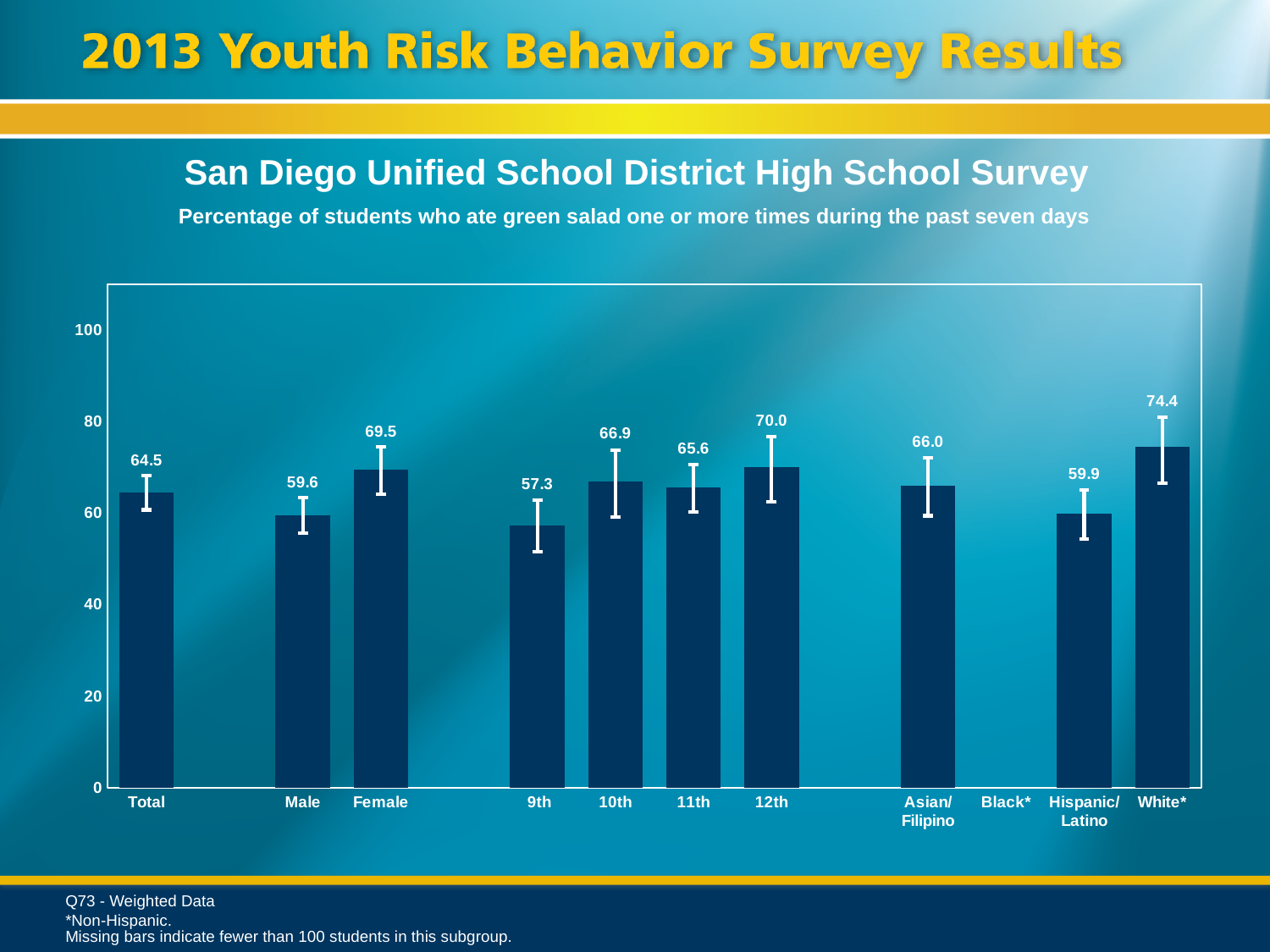
What kind of chart is shown? Bar chart Which is larger, the value for 10th grade or the value for 11th grade? 10th What is the difference between the Female and Male values? 9.9 What is the value for 12th grade? 70.0 What is the value for Female? 69.5 Which category has no bar shown on the chart? Black* What is the value for Total? 64.5 How many bars are plotted on the chart? 10 What is the difference between the 12th grade and 9th grade values? 12.7 What is the value for Hispanic/Latino? 59.9 Which category has the lowest value among the bars shown? 9th Which category has the highest value? White*